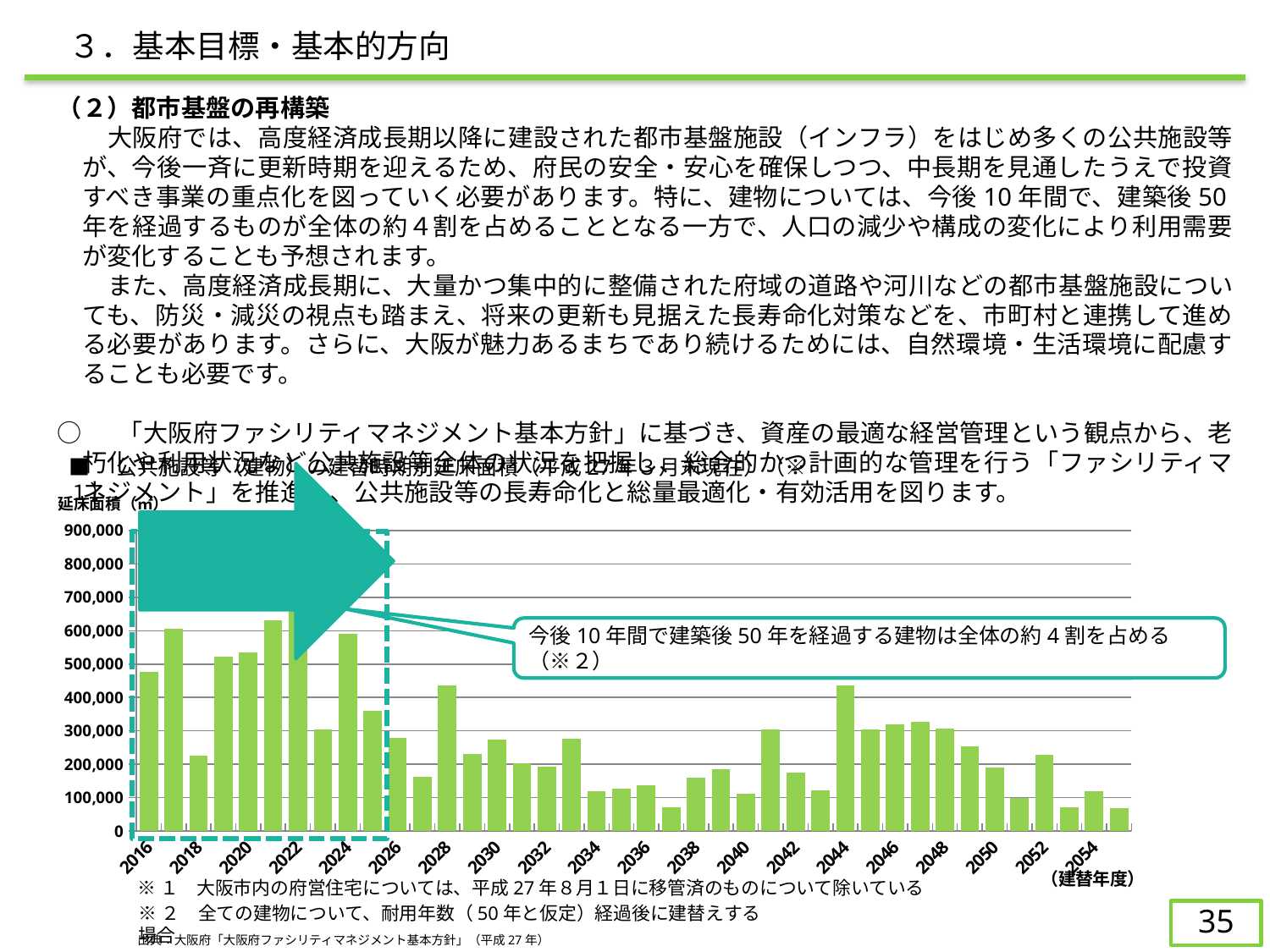
Which is larger, the value for 2017 or the value for 2018? 2017 Which is larger, the value for 2043 or the value for 2044? 2044 Is the value for 2017 greater or less than 500,000? greater What kind of chart is shown on the slide? bar chart Is the value for 2018 greater or less than 300,000? less Do the values generally rise or fall from 2016 to 2054? fall Is the value for 2044 greater or less than 400,000? greater What is the label on the vertical axis of the chart? 延床面積（㎡）